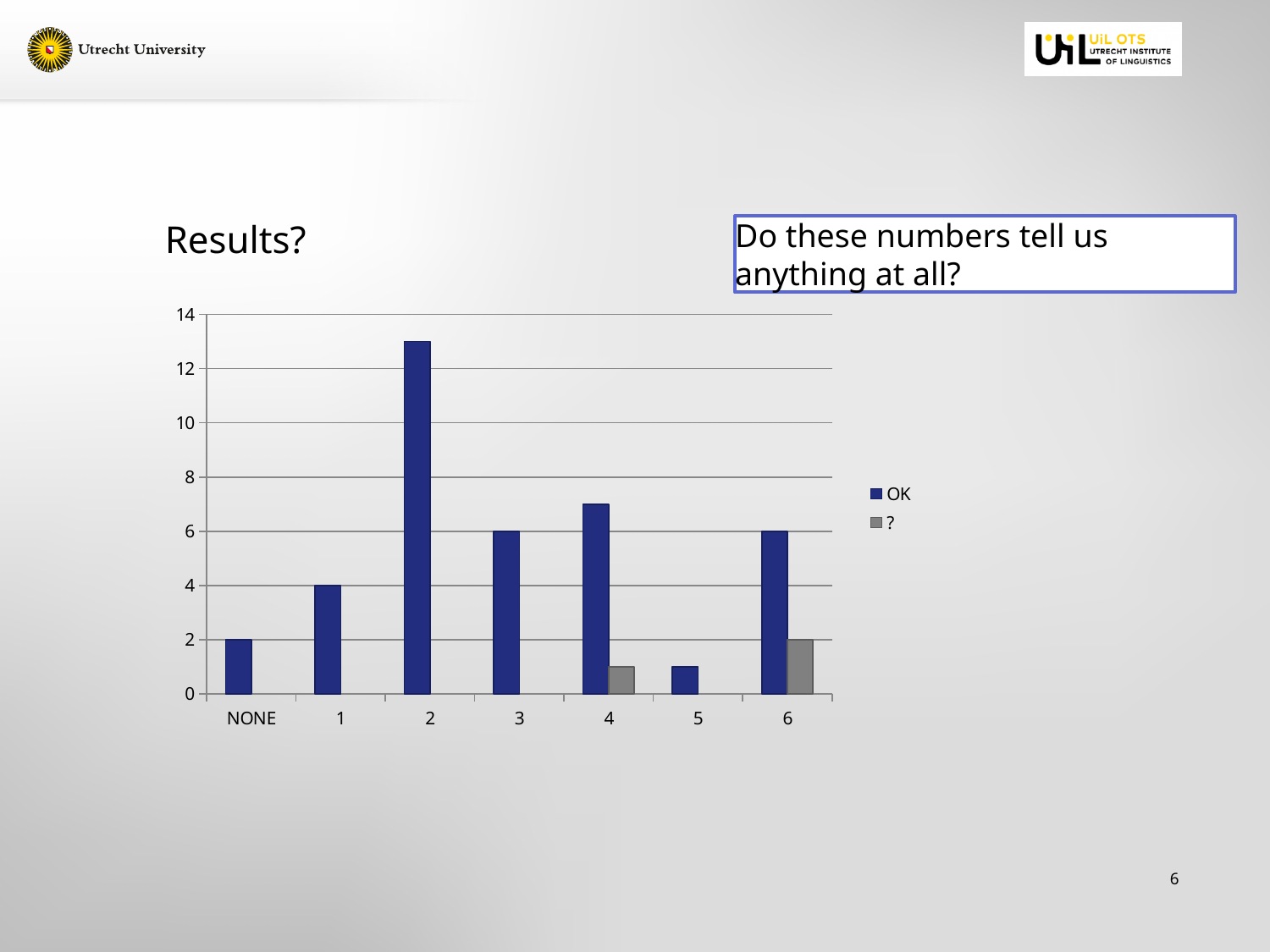
What is the OK value for category 1? 4 How many series does the legend list? 2 What kind of chart is shown on the slide? bar chart Which category has the lowest OK value? 5 Which has the larger OK value, category 1 or category 3? 3 Which category has the highest OK value? 2 What is the ? value for category 6? 2 How many categories are shown on the x axis? 7 What is the difference between the OK value for category 3 and the OK value for NONE? 4 Is the OK value for category 2 greater or less than 12? greater What is the OK value for NONE? 2 Is the OK value for category 4 greater or less than 8? less